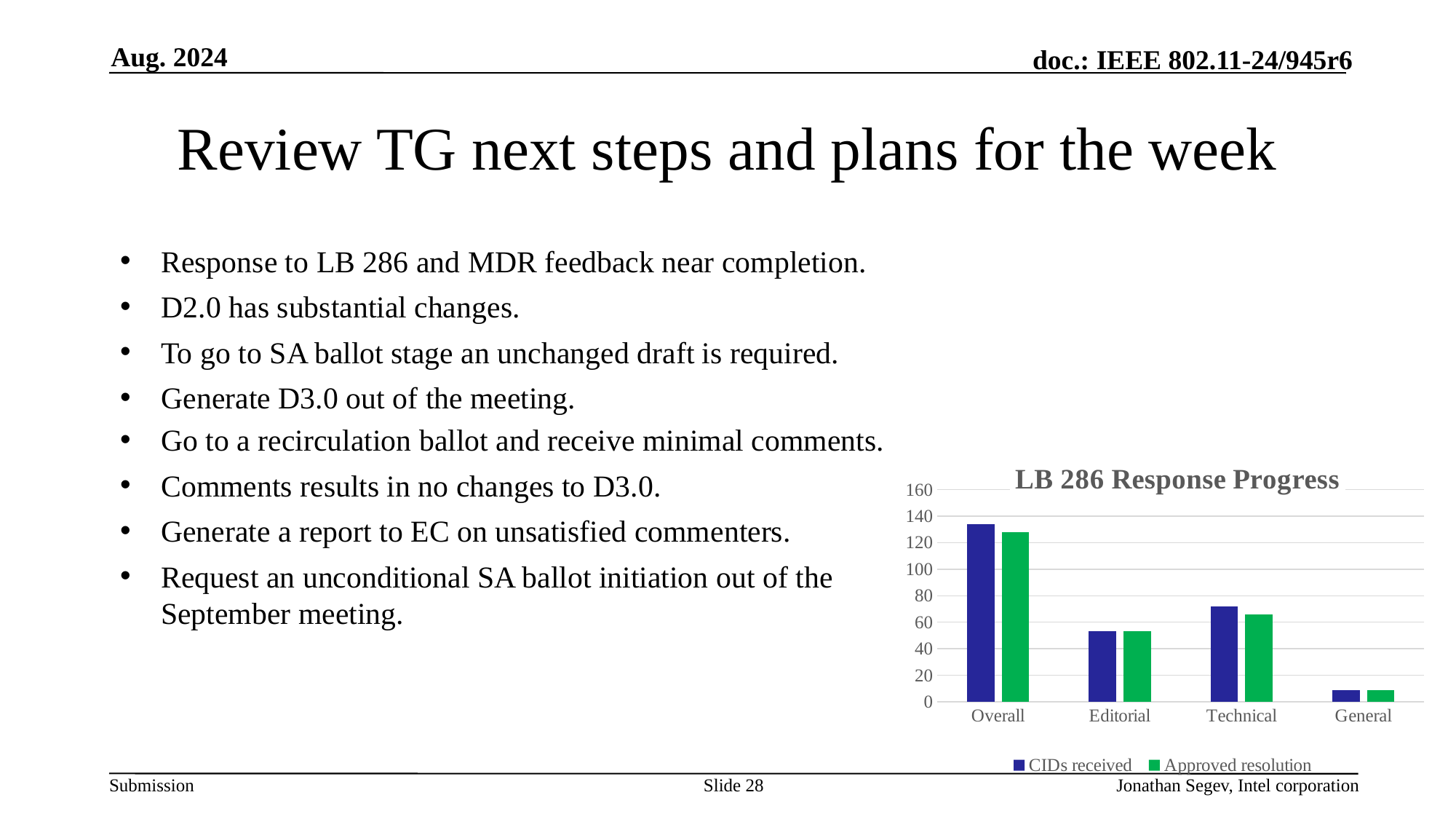
Is the value for CIDs received in the Overall category greater or less than 120? greater Which category has the highest value for CIDs received? Overall What is the title of the chart? LB 286 Response Progress How many categories are shown on the x axis of the chart? 4 Which is larger for CIDs received: Technical or Editorial? Technical Is the value for Approved resolution in the General category greater or less than 20? less How many series does the chart legend list? 2 Which category has the lowest value for Approved resolution? General Is the value for CIDs received in the Technical category greater or less than 80? less What type of chart is shown on the slide? bar chart In the Overall category, which is larger: CIDs received or Approved resolution? CIDs received